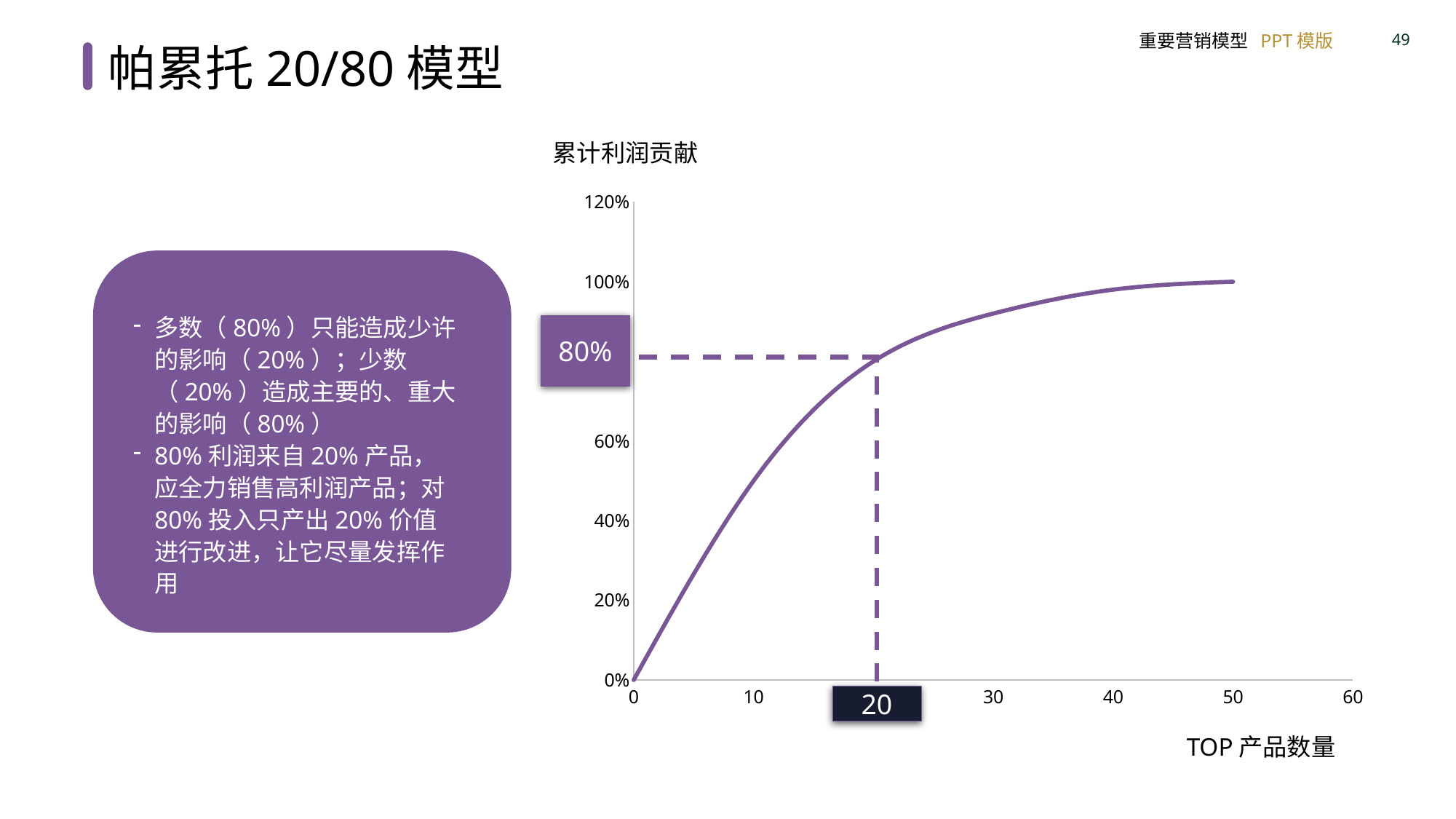
What is the title of the chart? 累计利润贡献 Is the cumulative profit contribution at 10 TOP products greater or less than 80%? less What is the cumulative profit contribution at 0 TOP products? 0% Does the cumulative profit contribution rise or fall as the number of TOP products increases? rise At how many TOP products does the highlighted dashed line meet the curve? 20 Is the cumulative profit contribution at 30 TOP products greater or less than 80%? greater Is the cumulative profit contribution at 40 TOP products greater or less than 80%? greater What is the x-axis label of the chart? TOP 产品数量 What cumulative profit contribution is highlighted at 20 TOP products? 80% What kind of chart is shown on the slide? line chart Is the cumulative profit contribution at 50 TOP products greater or less than the value at 20 TOP products? greater